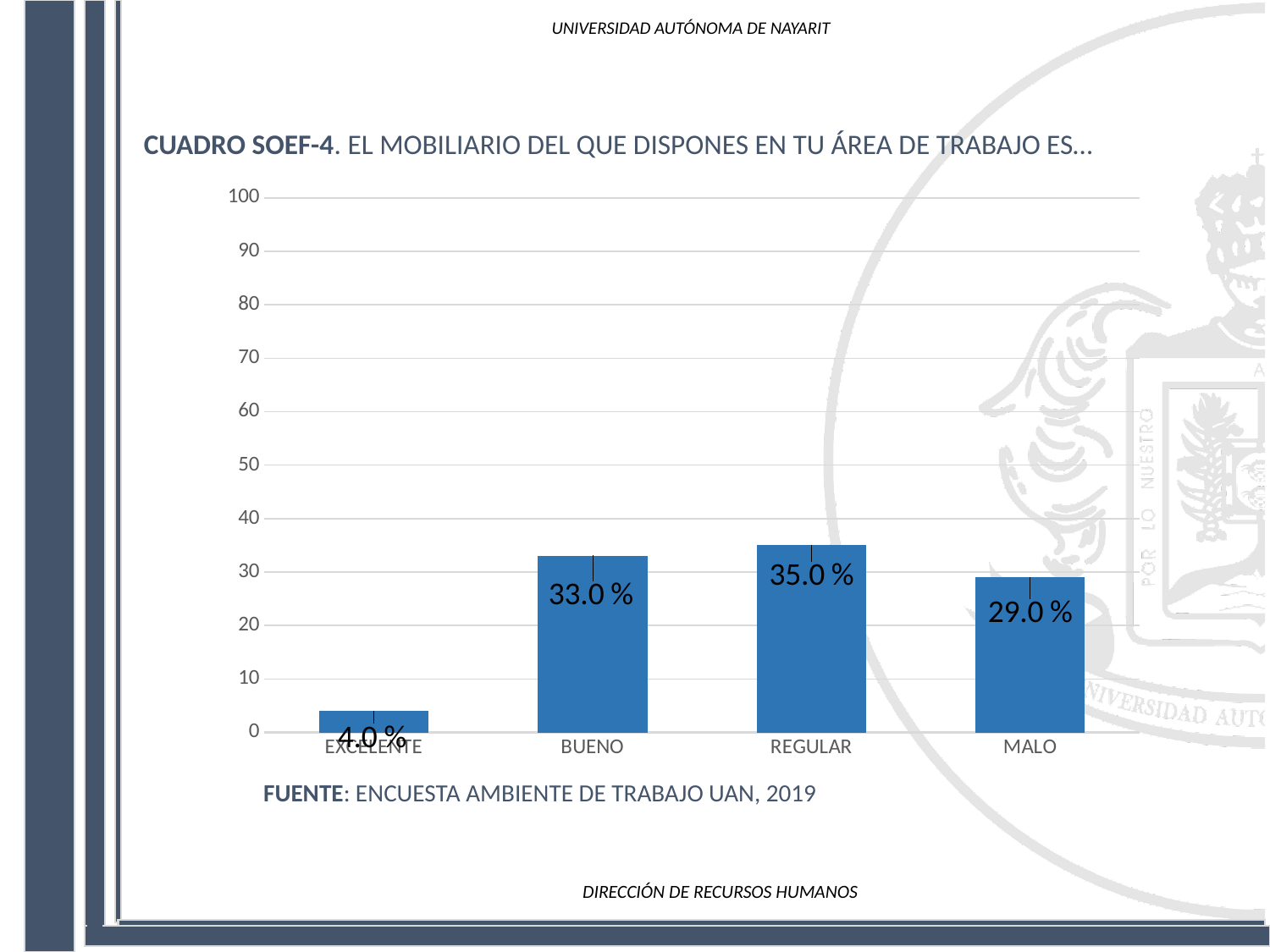
What is the value for BUENO? 33.0 % Which category has the highest value? REGULAR Which is larger, the value for BUENO or the value for MALO? BUENO What kind of chart is shown on the slide? bar chart Is the value for REGULAR greater or less than 30? greater What is the maximum value shown on the y axis? 100 Which category has the lowest value? EXCELENTE How many categories are shown on the x axis? 4 What is the value for MALO? 29.0 % What is the difference between the values for REGULAR and MALO? 6.0 % What source is cited below the chart? ENCUESTA AMBIENTE DE TRABAJO UAN, 2019 What is the value for EXCELENTE? 4.0 %